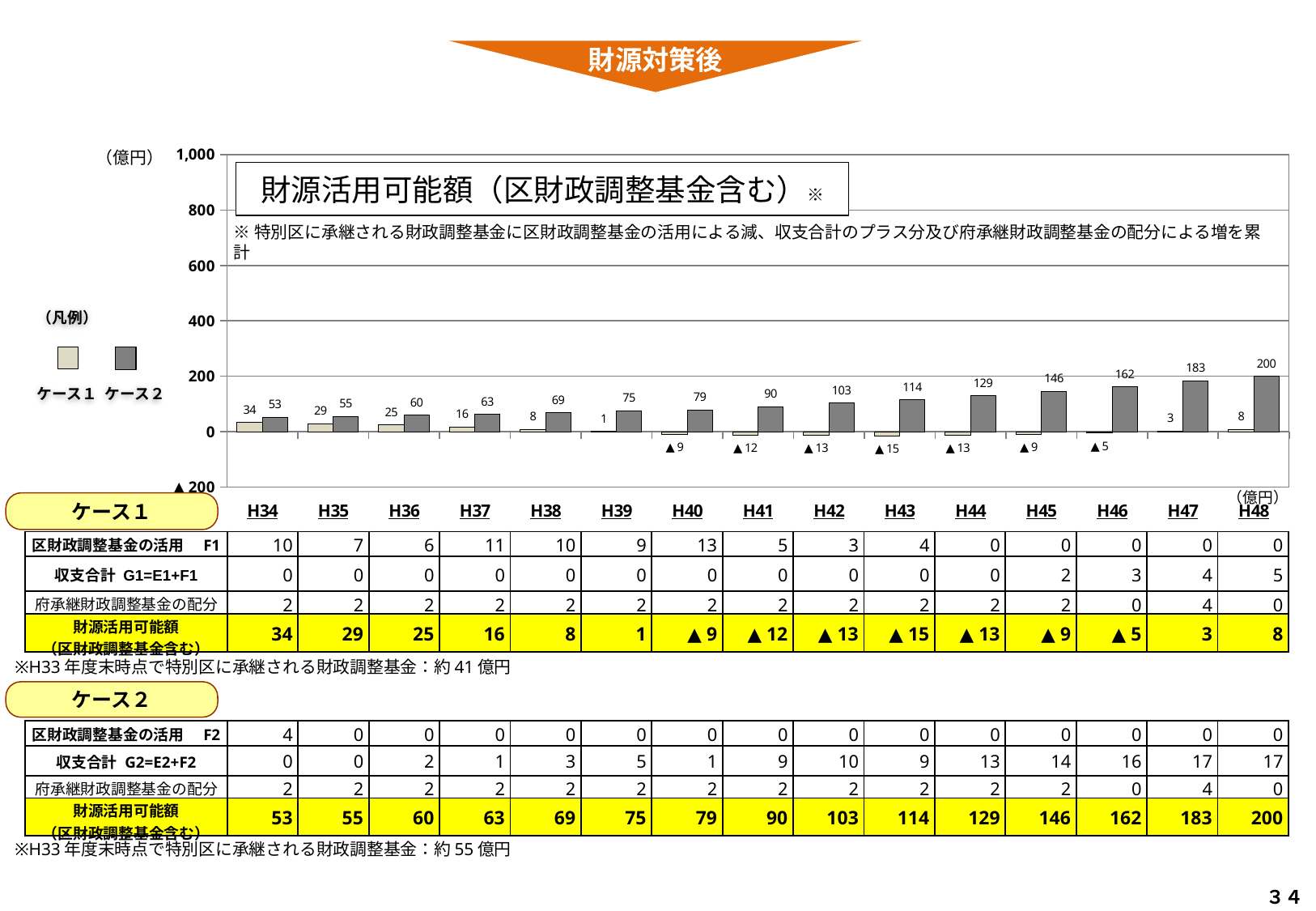
What is the difference between ケース2 and ケース1 in H34? 19 In which year is the value for ケース1 lowest? H43 What is the value for ケース2 in H42? 103 Which is larger in H40, the value for ケース1 or ケース2? ケース2 In which year is the value for ケース2 highest? H48 What is the value for ケース1 in H43? ▲15 What is the value for ケース1 in H34? 34 How many years are shown on the x axis of the chart? 15 Does the value for ケース2 rise or fall from H34 to H48? rise What is the value for ケース2 in H48? 200 How many series does the legend list? 2 Is the value for ケース2 in H47 greater or less than 200? less